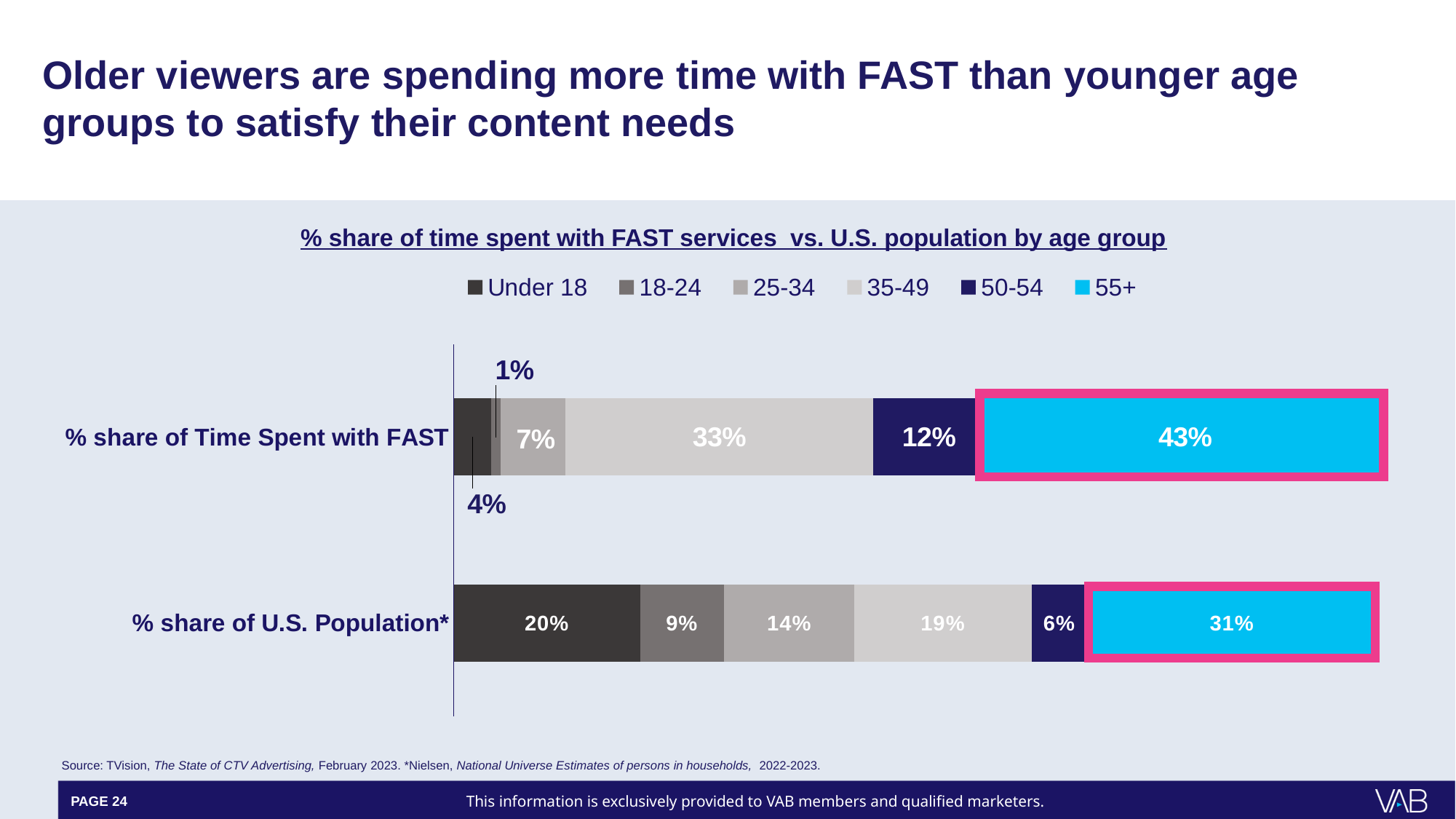
What is the 18-24 share of time spent with FAST? 1% Which age group has the smallest share of the U.S. population? 50-54 How many bars (categories) are plotted in the chart? 2 Which is larger: the 50-54 share of time spent with FAST or the 50-54 share of the U.S. population? % share of Time Spent with FAST What is the 55+ share of time spent with FAST? 43% What is the difference between the 55+ share of time spent with FAST and the 55+ share of the U.S. population? 12% What is the 35-49 share of time spent with FAST? 33% Which age group has the largest share of time spent with FAST? 55+ What is the Under 18 share of the U.S. population? 20% What type of chart is shown on the slide? Stacked bar chart How many series does the legend list? 6 What is the total of the % share of Time Spent with FAST bar? 100%